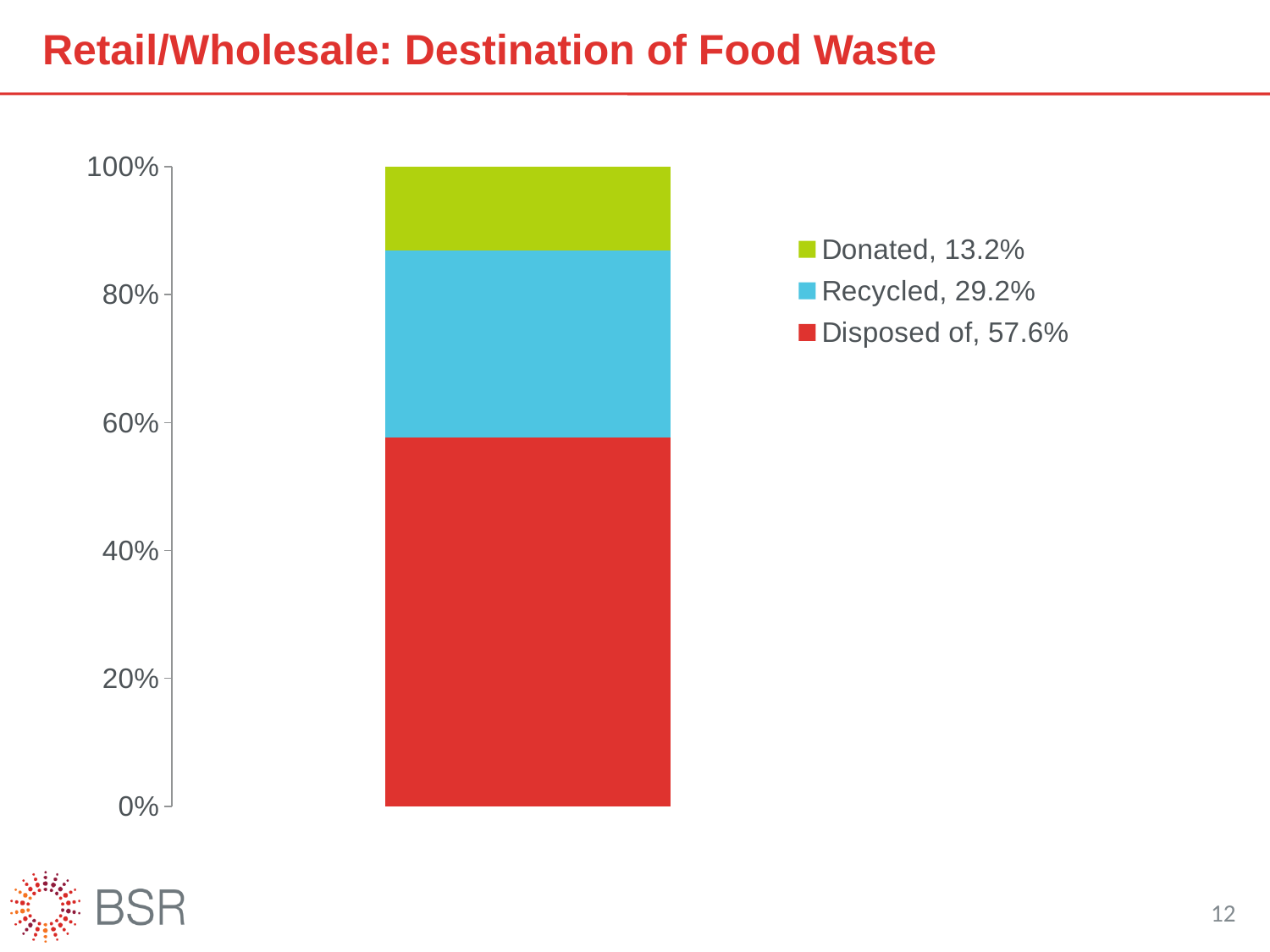
Which destination accounts for the smallest share of food waste? Donated How many series does the legend list? 3 What percentage of food waste is recycled? 29.2% What colour represents the Recycled series? Blue What kind of chart is shown on the slide? Stacked bar chart What percentage of food waste is donated? 13.2% What percentage of food waste is disposed of? 57.6% Which is larger, the Recycled share or the Donated share? Recycled Which destination accounts for the largest share of food waste? Disposed of What is the difference between the Recycled share and the Donated share? 16.0% What is the difference between the Disposed of share and the Recycled share? 28.4% Is the Disposed of share greater or less than 60%? less